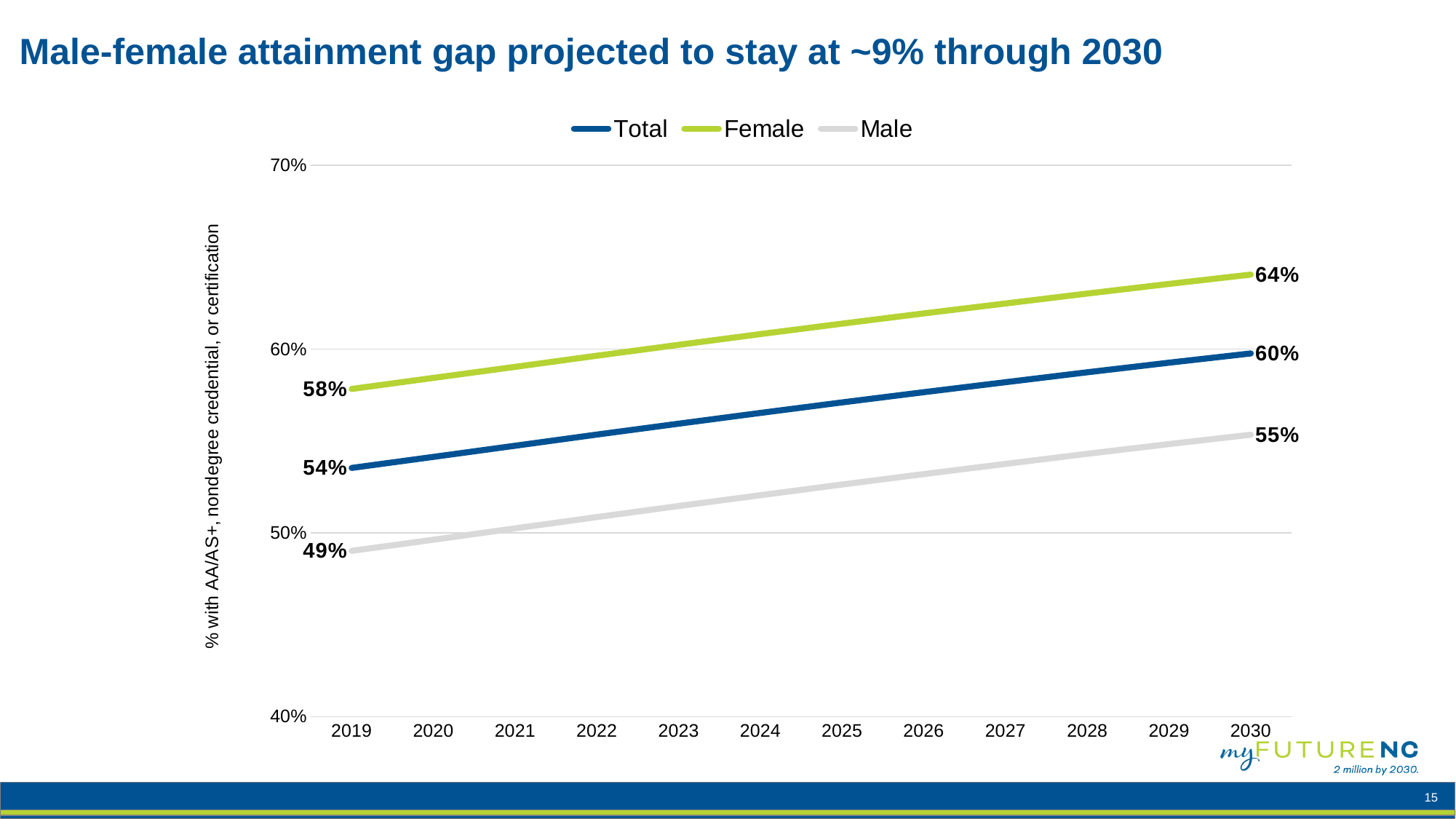
Which series has the lowest value in 2019? Male What is the Male value in 2030? 55% Does the Male series rise or fall from 2019 to 2030? Rise What is the difference between the Total value in 2030 and the Total value in 2019? 6% Which series has the highest value in 2030? Female What is the Total value in 2019? 54% What kind of chart is shown on the slide? Line chart What is the Female value in 2019? 58% What is the Female value in 2030? 64% How many series does the legend list? 3 What is the difference between the Female and Male values in 2030? 9% Is the Male value in 2025 greater or less than 50%? greater